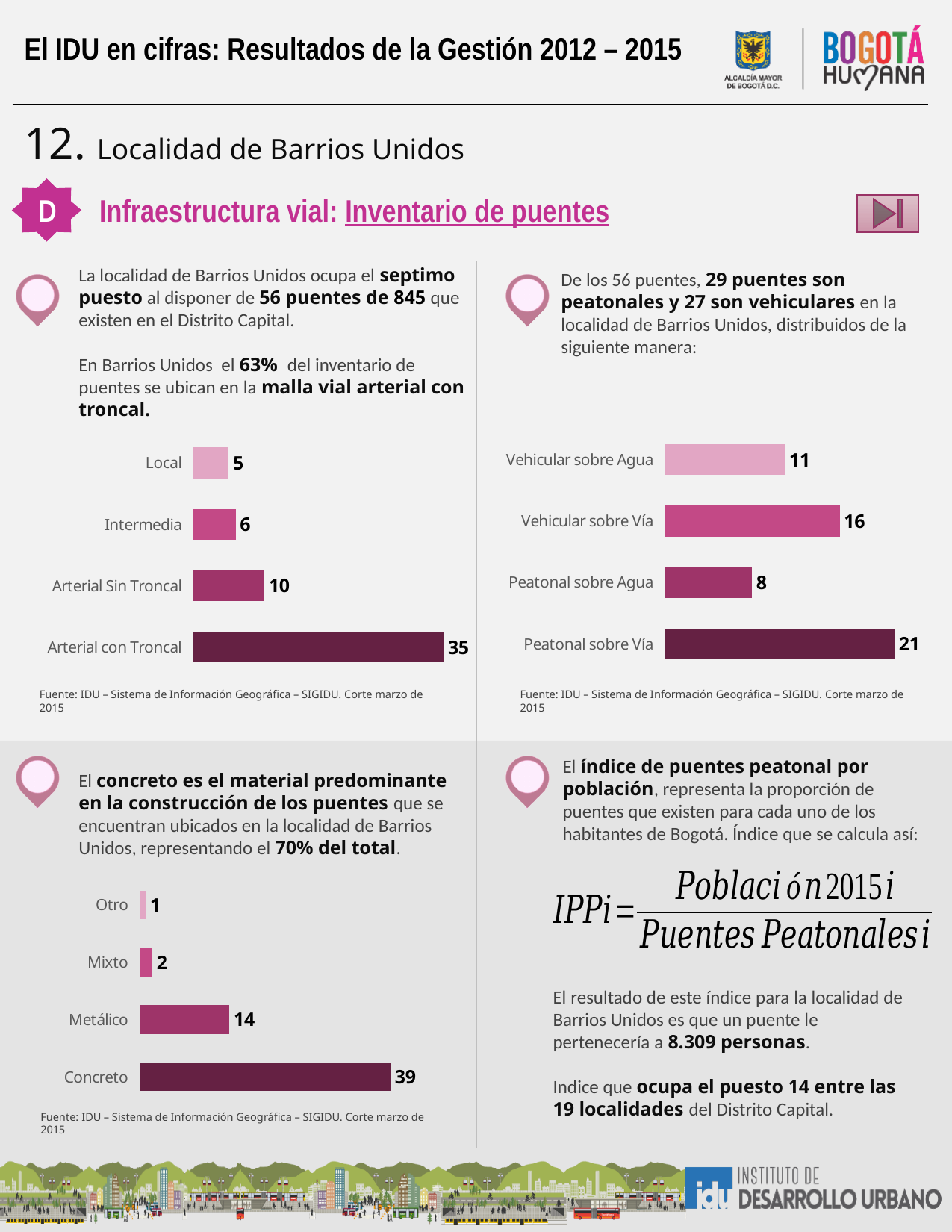
In the top-left bar chart, what is the value for Arterial con Troncal? 35 In the top-right bar chart, what is the value for Vehicular sobre Vía? 16 In the top-right bar chart, which is larger, Vehicular sobre Agua or Peatonal sobre Agua? Vehicular sobre Agua In the bottom-left bar chart, what is the difference between Concreto and Metálico? 25 In the top-right bar chart, which category has the highest value? Peatonal sobre Vía In the top-left bar chart, which category has the lowest value? Local In the top-left bar chart, what is the difference between Arterial con Troncal and Arterial Sin Troncal? 25 What type of chart is the bottom-left chart? Bar chart How many categories does the top-left bar chart show? 4 In the bottom-left bar chart, what is the value for Metálico? 14 In the bottom-left bar chart, which category has the lowest value? Otro In the top-right bar chart, what is the difference between Peatonal sobre Vía and Peatonal sobre Agua? 13